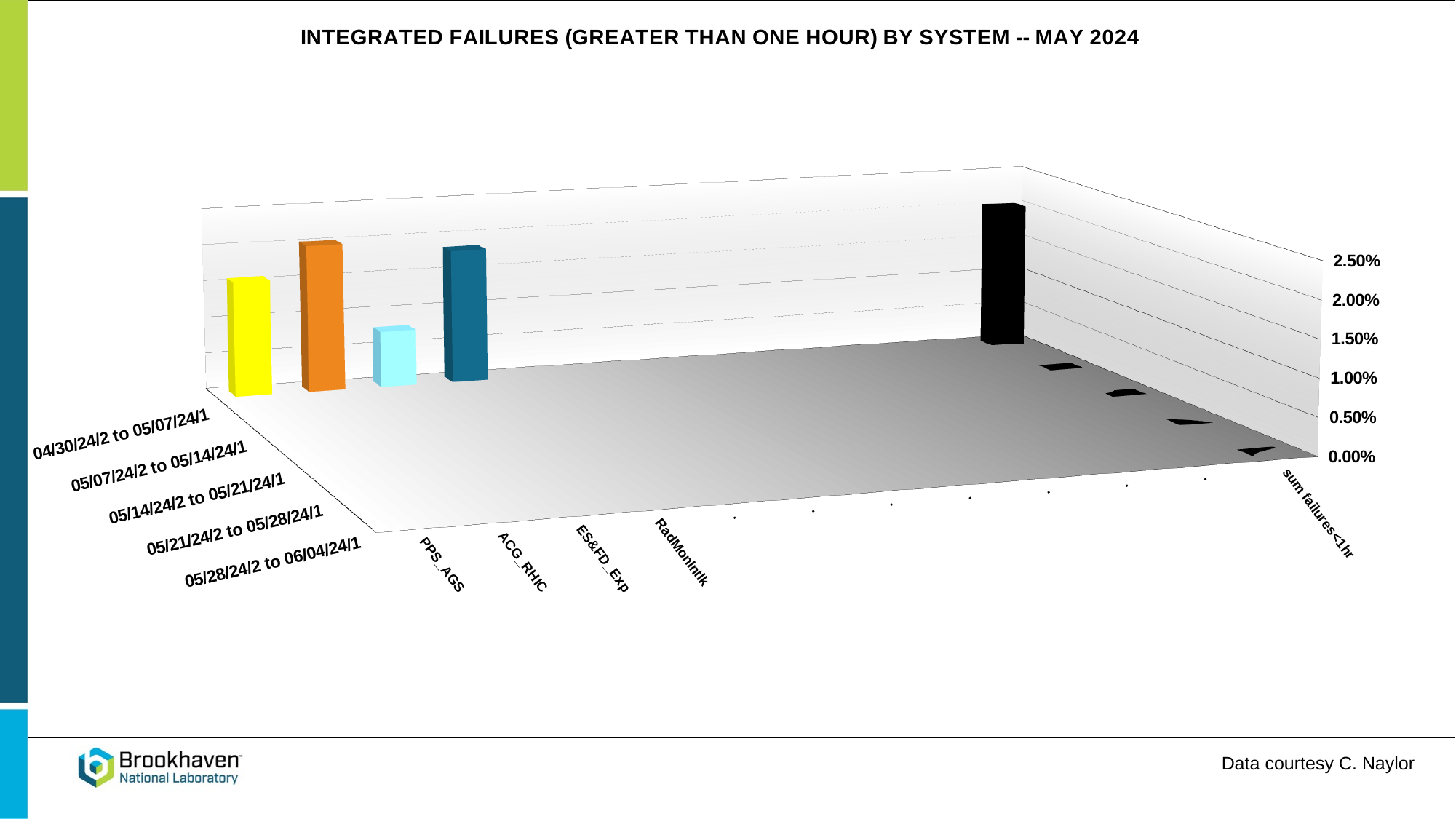
How many weekly periods are listed along the depth axis of the chart? 5 What is the title of the chart? INTEGRATED FAILURES (GREATER THAN ONE HOUR) BY SYSTEM -- MAY 2024 What is the highest value shown on the percentage axis? 2.50% What kind of chart is shown on the slide? bar chart Is the value for ACG_RHIC in the period 04/30/24/2 to 05/07/24/1 greater or less than 0.50%? greater Is the value for PPS_AGS in the period 04/30/24/2 to 05/07/24/1 greater or less than 0.50%? greater